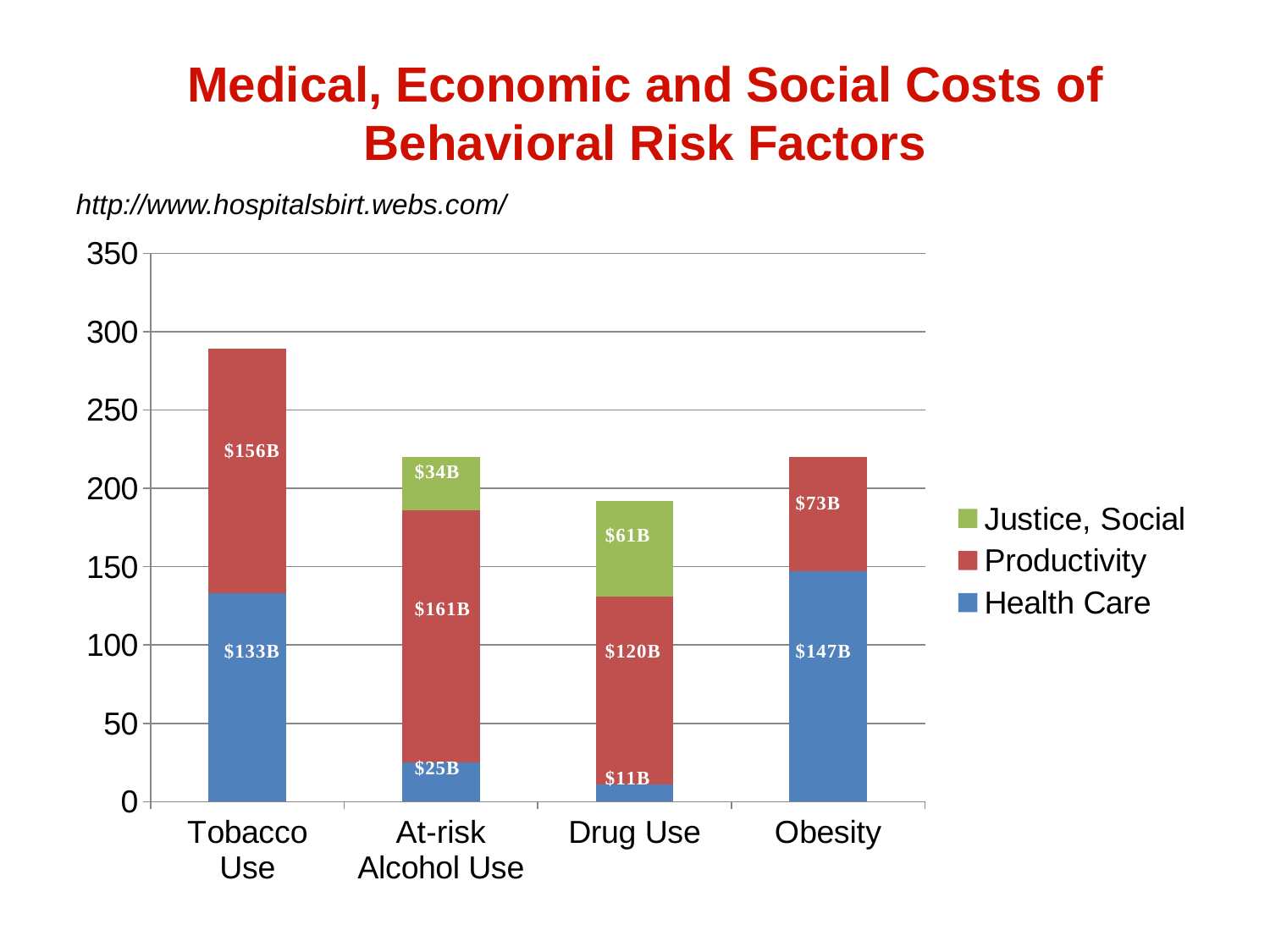
Which category has the highest Health Care cost? Obesity What is the Justice, Social cost for Drug Use? $61B How many series does the legend list? 3 What kind of chart is shown on the slide? Stacked bar chart Which category has the lowest Health Care cost? Drug Use What is the total of the stacked bar for At-risk Alcohol Use? $220B Which is larger: the Justice, Social cost for Drug Use or the Justice, Social cost for At-risk Alcohol Use? Drug Use Which category has the tallest stacked bar overall? Tobacco Use What is the difference between the Productivity cost for Tobacco Use and the Productivity cost for Obesity? $83B What is the Health Care cost for Tobacco Use? $133B What is the Productivity cost for At-risk Alcohol Use? $161B What is the Health Care cost for Obesity? $147B